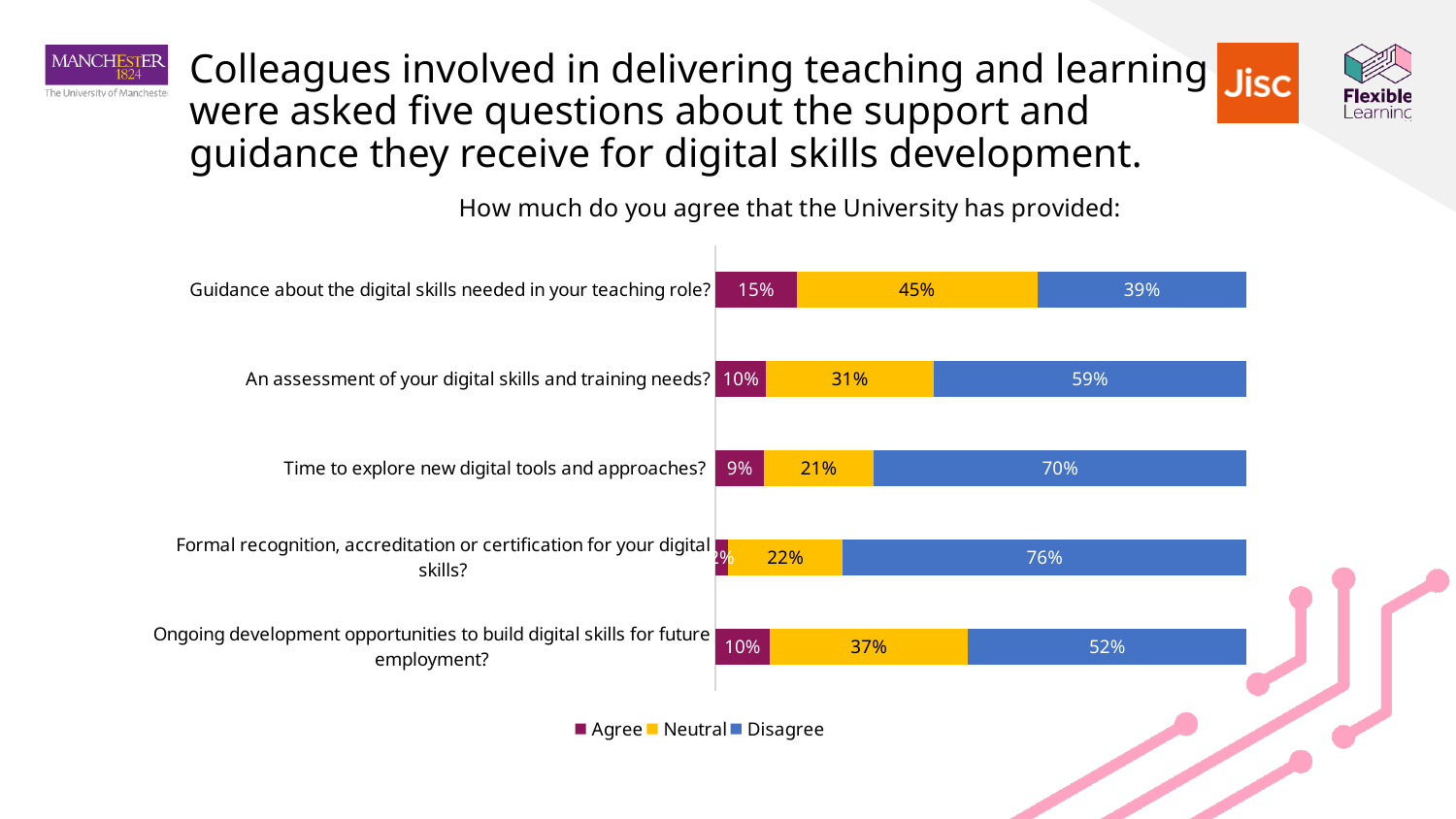
What is the difference between the Disagree values for 'Time to explore new digital tools and approaches?' and 'Ongoing development opportunities to build digital skills for future employment?' 18% How many questions (categories) are plotted in the chart? 5 What type of chart is shown on the slide? Stacked bar chart How many series does the legend list? 3 Which is larger: the Neutral value for 'Ongoing development opportunities to build digital skills for future employment?' or the Neutral value for 'An assessment of your digital skills and training needs?' Ongoing development opportunities to build digital skills for future employment? Which question has the highest Disagree percentage? Formal recognition, accreditation or certification for your digital skills? Which question has the highest Agree percentage? Guidance about the digital skills needed in your teaching role? What percentage of respondents disagreed that the University has provided time to explore new digital tools and approaches? 70% What is the total of the Agree, Neutral and Disagree values for 'Time to explore new digital tools and approaches?' 100% What is the Neutral value for 'Guidance about the digital skills needed in your teaching role?' 45% What is the Agree value for 'An assessment of your digital skills and training needs?' 10% Which colour represents the Disagree series in the chart? Blue